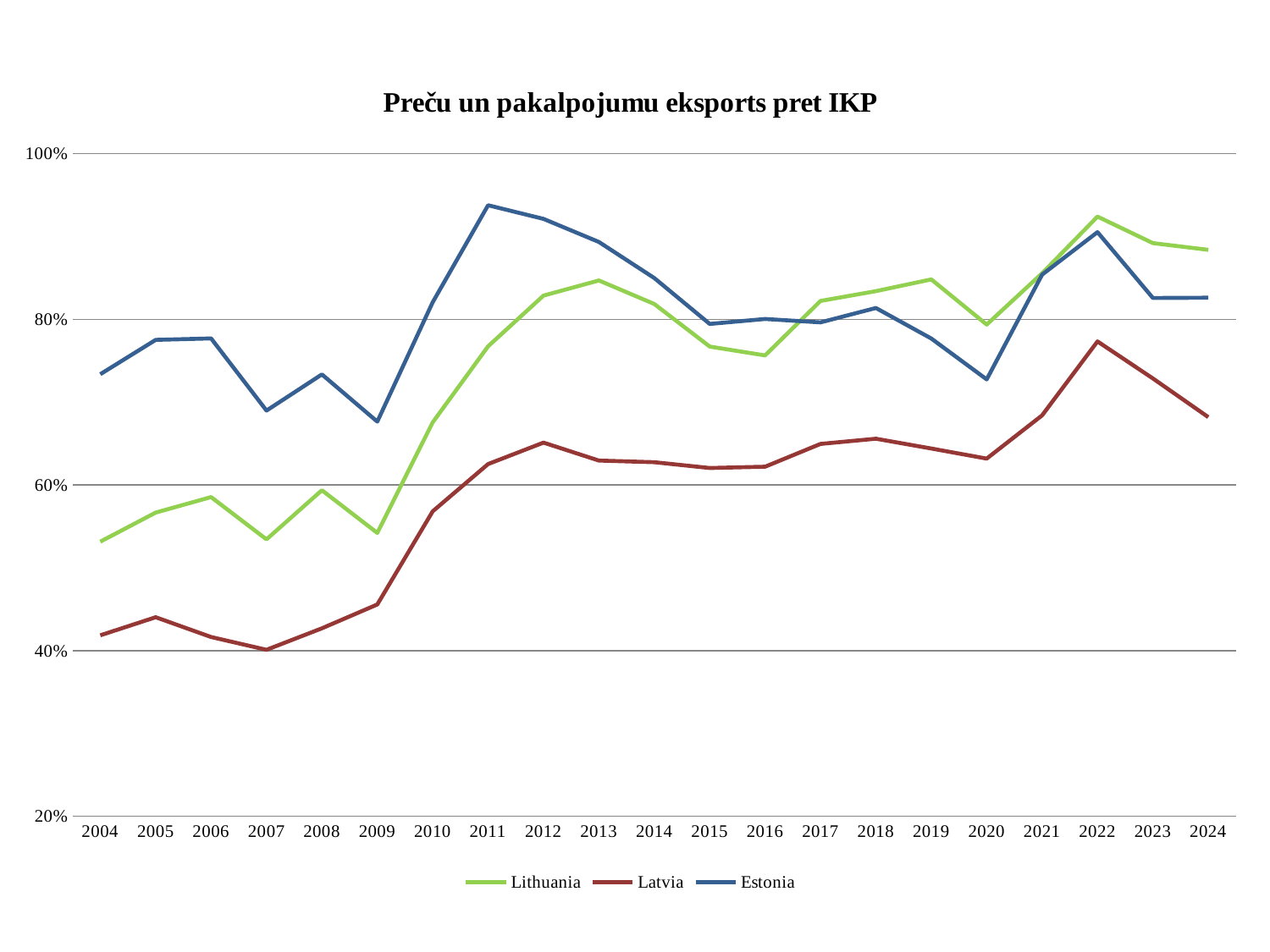
What is the title of the chart? Preču un pakalpojumu eksports pret IKP Which series is drawn in red? Latvia In 2011, which is higher: Estonia or Lithuania? Estonia What kind of chart is shown on the slide? line chart In which year does Latvia reach its highest value? 2022 Is the value for Lithuania in 2004 greater or less than 60%? less In 2024, which is higher: Lithuania or Latvia? Lithuania Is the value for Latvia in 2022 greater or less than 80%? less Is the value for Estonia in 2011 greater or less than 80%? greater How many years are shown on the x axis? 21 Does the Latvia line rise or fall from 2022 to 2024? fall How many series does the legend list? 3